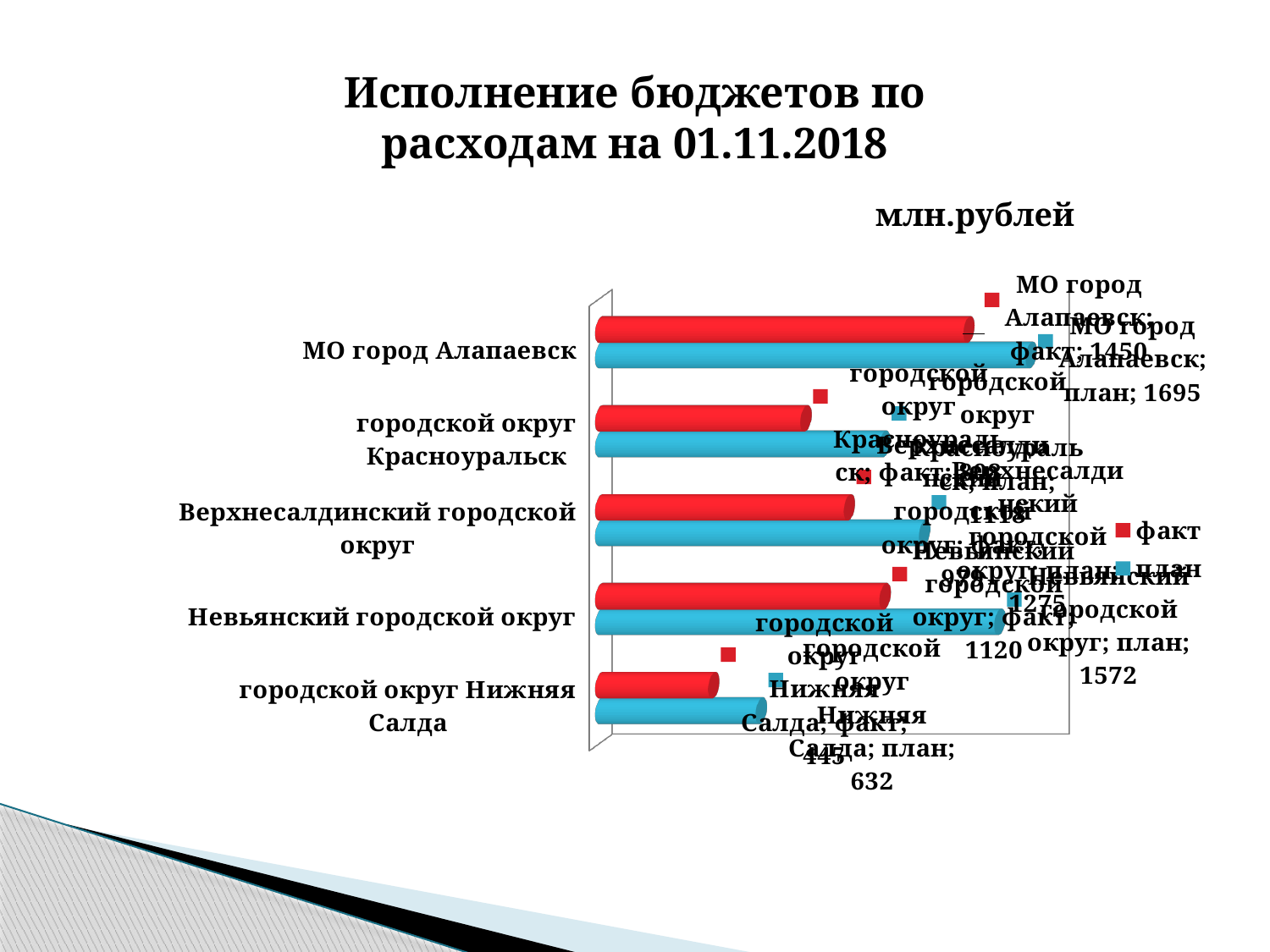
How many municipalities (categories) are shown on the chart? 5 How many series does the legend list? 2 What are the two series named in the legend? факт and план Which municipality has the longest план bar? МО город Алапаевск What is the план value for Невьянский городской округ? 1572 What is the план value for МО город Алапаевск? 1695 What is the план value for городской округ Нижняя Салда? 632 What is the факт value for МО город Алапаевск? 1450 What type of chart is shown on the slide? bar chart What is the факт value for городской округ Нижняя Салда? 445 What is the difference between план and факт for МО город Алапаевск? 245 In what units are the values on the chart expressed? млн.рублей